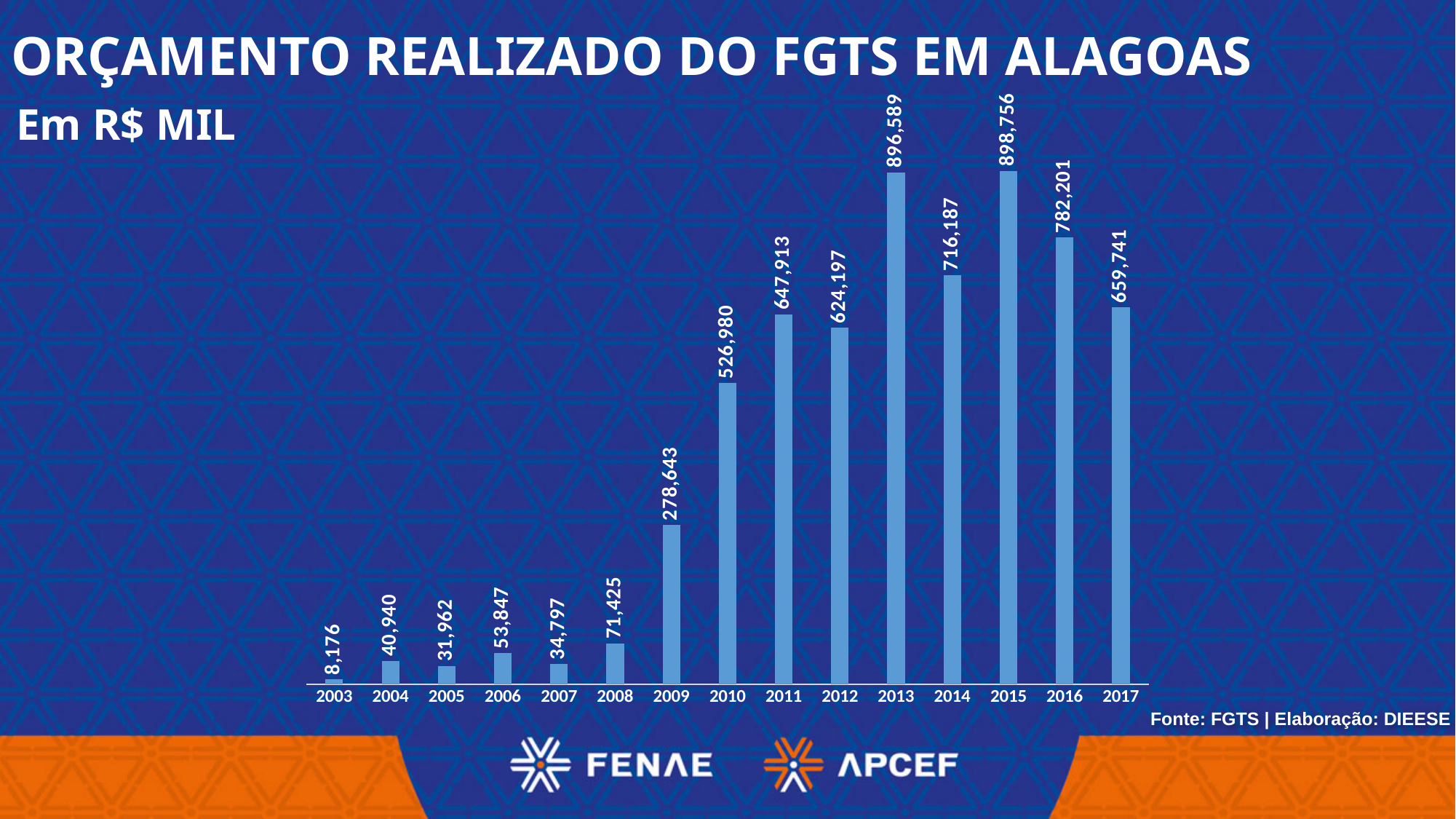
What is the difference between the values for 2016 and 2017? 122,460 Which is larger, the value for 2011 or the value for 2012? 2011 How many years are shown on the chart? 15 Which year has the highest value? 2015 What is the value for 2017? 659,741 Which year has the lowest value? 2003 What is the value for 2009? 278,643 What unit is stated below the chart title? Em R$ MIL Which is larger, the value for 2004 or the value for 2005? 2004 What is the difference between the values for 2015 and 2013? 2,167 What is the value for 2013? 896,589 What kind of chart is shown on the slide? Bar chart